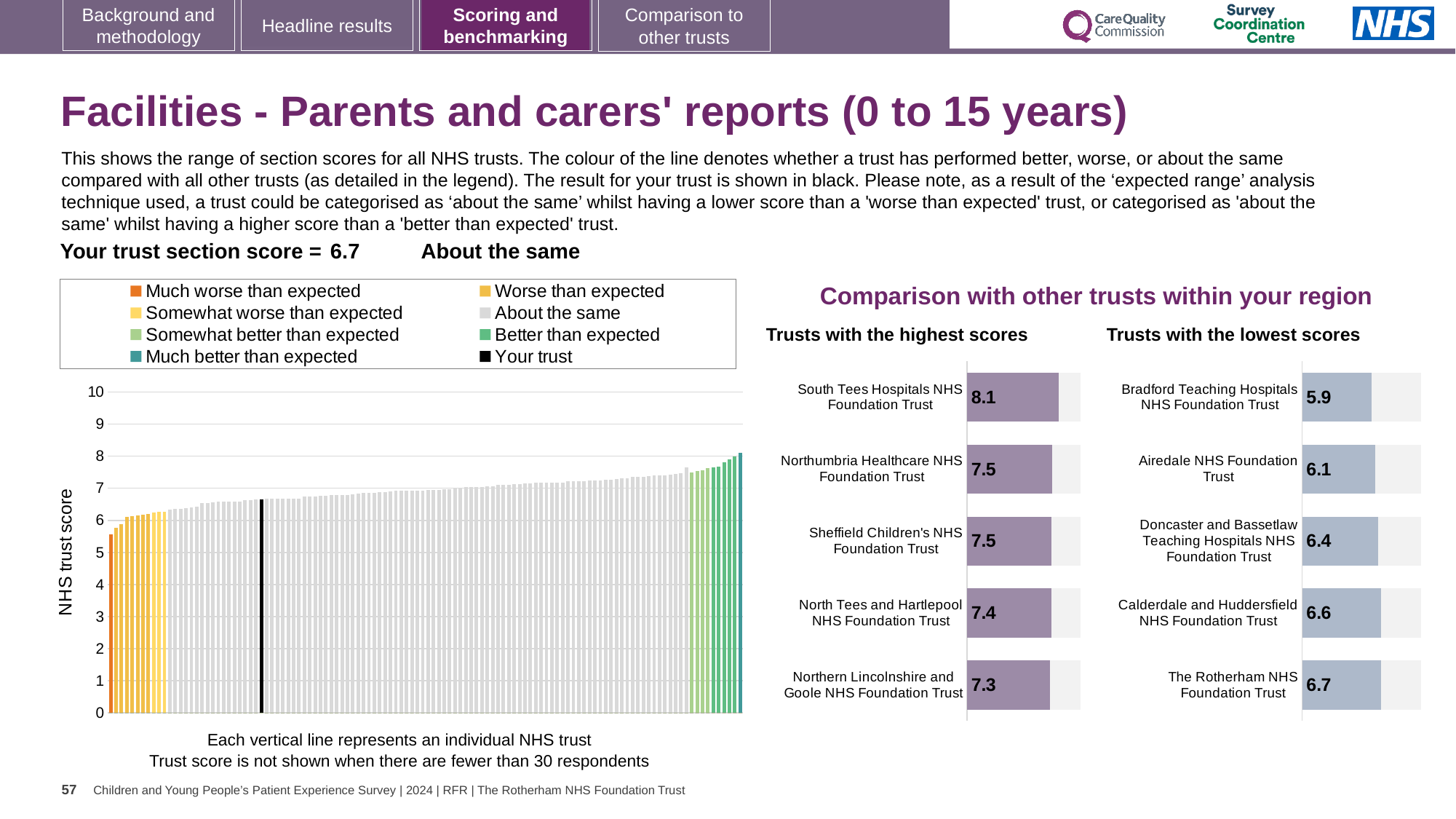
In the 'Trusts with the lowest scores' chart, what is the difference between the scores of The Rotherham NHS Foundation Trust and Airedale NHS Foundation Trust? 0.6 In the 'Trusts with the highest scores' chart, what is the score for South Tees Hospitals NHS Foundation Trust? 8.1 In the 'Trusts with the lowest scores' chart, what is the score for Bradford Teaching Hospitals NHS Foundation Trust? 5.9 In the main chart of NHS trust scores on the left, is the value for the black 'Your trust' bar greater or less than 7? less In the 'Trusts with the highest scores' chart, which trust has the highest score? South Tees Hospitals NHS Foundation Trust What kind of chart is the 'Trusts with the lowest scores' chart? bar chart How many entries does the legend of the main chart on the left list? 8 In the 'Trusts with the highest scores' chart, what is the difference between the scores of South Tees Hospitals NHS Foundation Trust and Northern Lincolnshire and Goole NHS Foundation Trust? 0.8 How many trusts are shown in the 'Trusts with the highest scores' chart? 5 In the 'Trusts with the lowest scores' chart, which has the larger score: Doncaster and Bassetlaw Teaching Hospitals NHS Foundation Trust or Calderdale and Huddersfield NHS Foundation Trust? Calderdale and Huddersfield NHS Foundation Trust In the 'Trusts with the lowest scores' chart, which trust has the lowest score? Bradford Teaching Hospitals NHS Foundation Trust In the main chart of NHS trust scores on the left, do the values rise or fall from left to right? rise